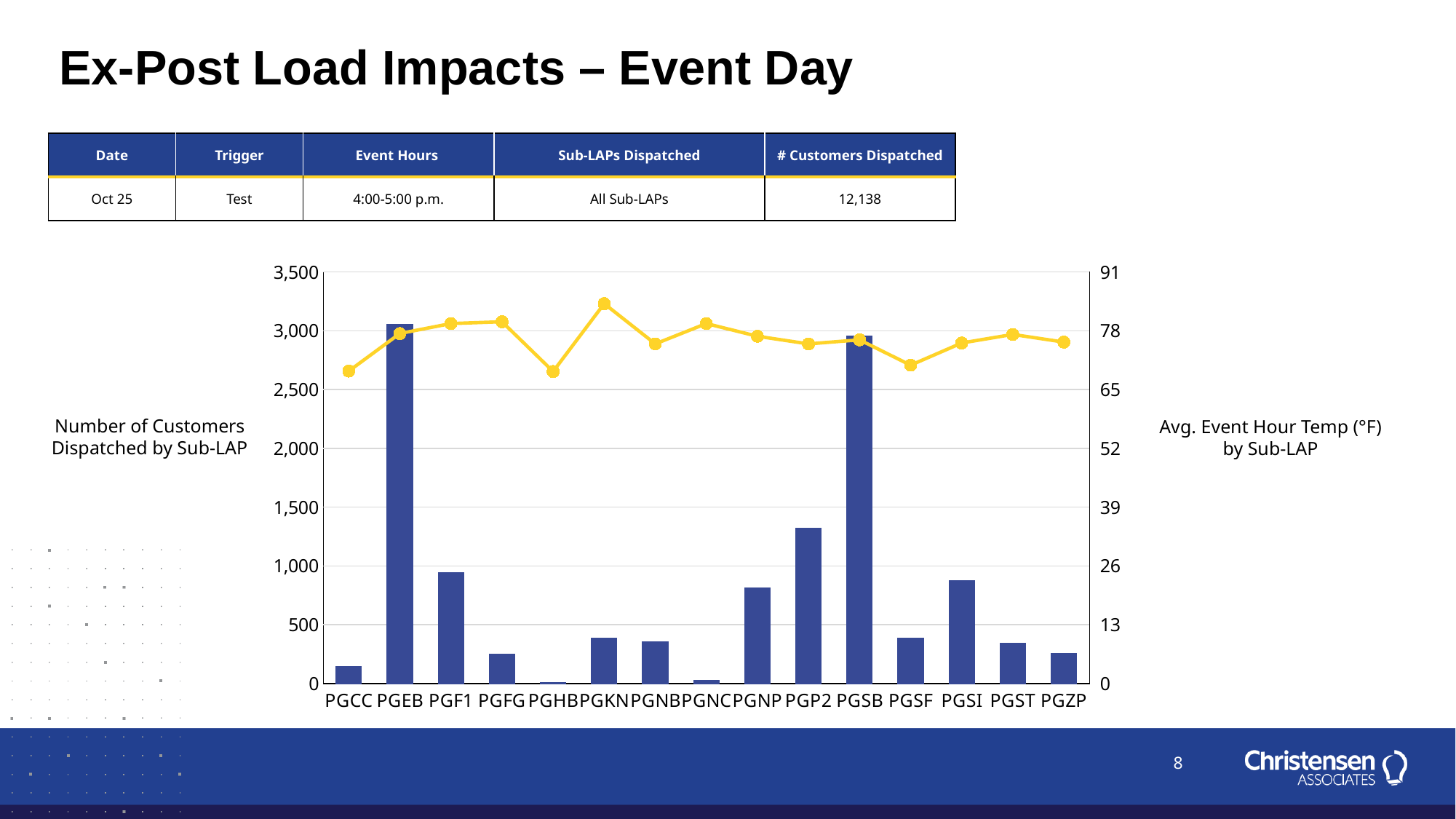
What does the right-hand axis of the chart measure? Avg. Event Hour Temp (°F) by Sub-LAP Is the number of customers dispatched for PGCC greater or less than 500? less How many Sub-LAP categories are shown on the x axis of the chart? 15 Is the number of customers dispatched for PGNP greater or less than 1,000? less Is the number of customers dispatched for PGSF greater or less than 500? less Which Sub-LAP has the lowest number of customers dispatched in the chart? PGHB Which Sub-LAP has the highest average event hour temperature on the line? PGKN Which has more customers dispatched, PGP2 or PGNP? PGP2 Which has more customers dispatched, PGSI or PGSF? PGSI